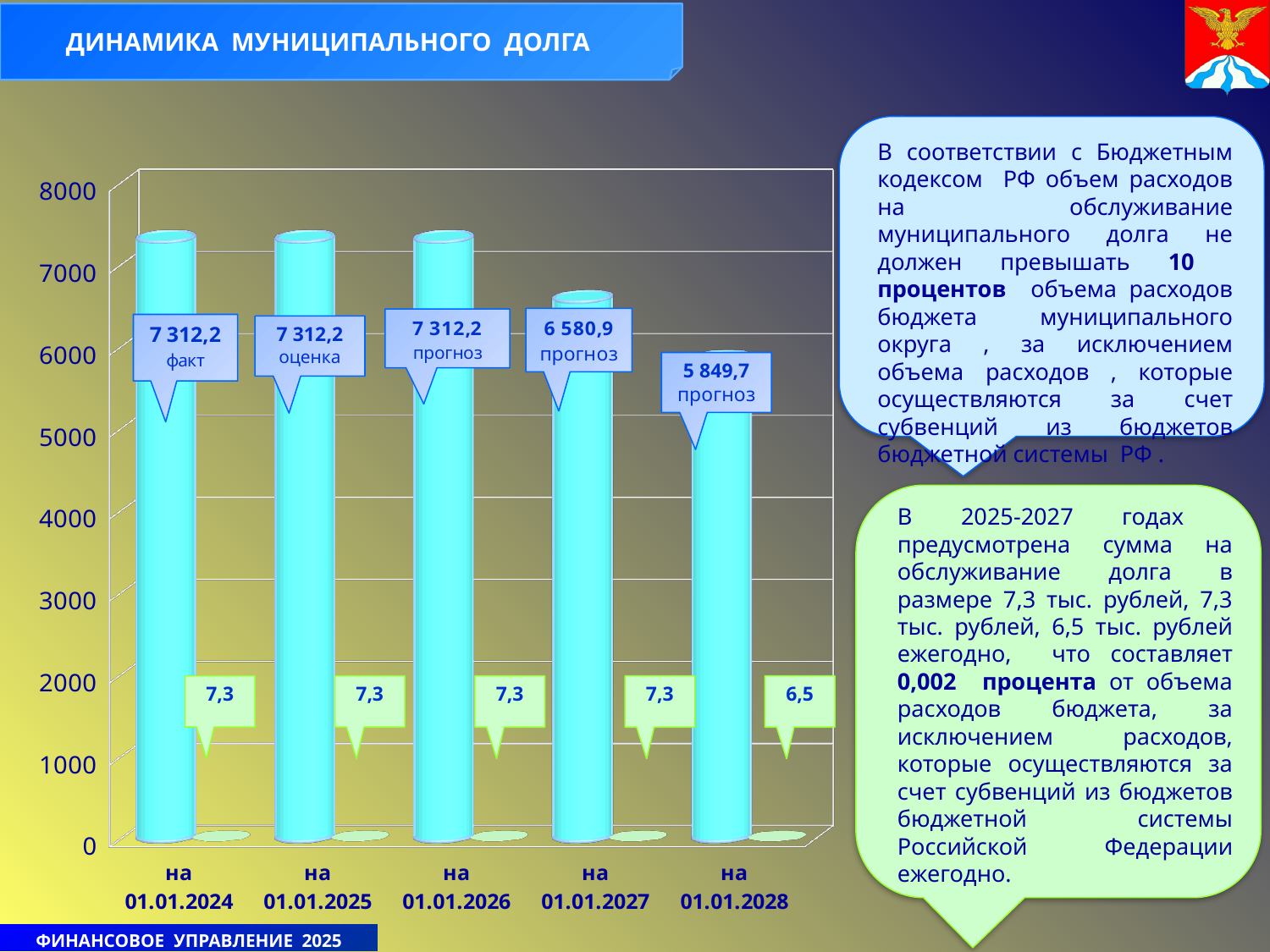
Which date has the lowest municipal debt value on the chart? на 01.01.2028 What is the municipal debt value shown for на 01.01.2028? 5 849,7 What kind of chart is shown on the slide? bar chart What is the difference between the debt values for на 01.01.2027 and на 01.01.2028? 731,2 Is the debt value for на 01.01.2028 greater or less than 6000? less Do the debt values rise or fall from на 01.01.2026 to на 01.01.2028? fall Which is larger: the debt value for на 01.01.2025 or for на 01.01.2027? на 01.01.2025 What is the difference between the debt values for на 01.01.2026 and на 01.01.2028? 1 462,5 What is the municipal debt value shown for на 01.01.2027? 6 580,9 What label is attached to the bar for на 01.01.2024 (факт, оценка or прогноз)? факт What is the municipal debt value shown for на 01.01.2024? 7 312,2 How many bars (dates) are shown on the chart? 5